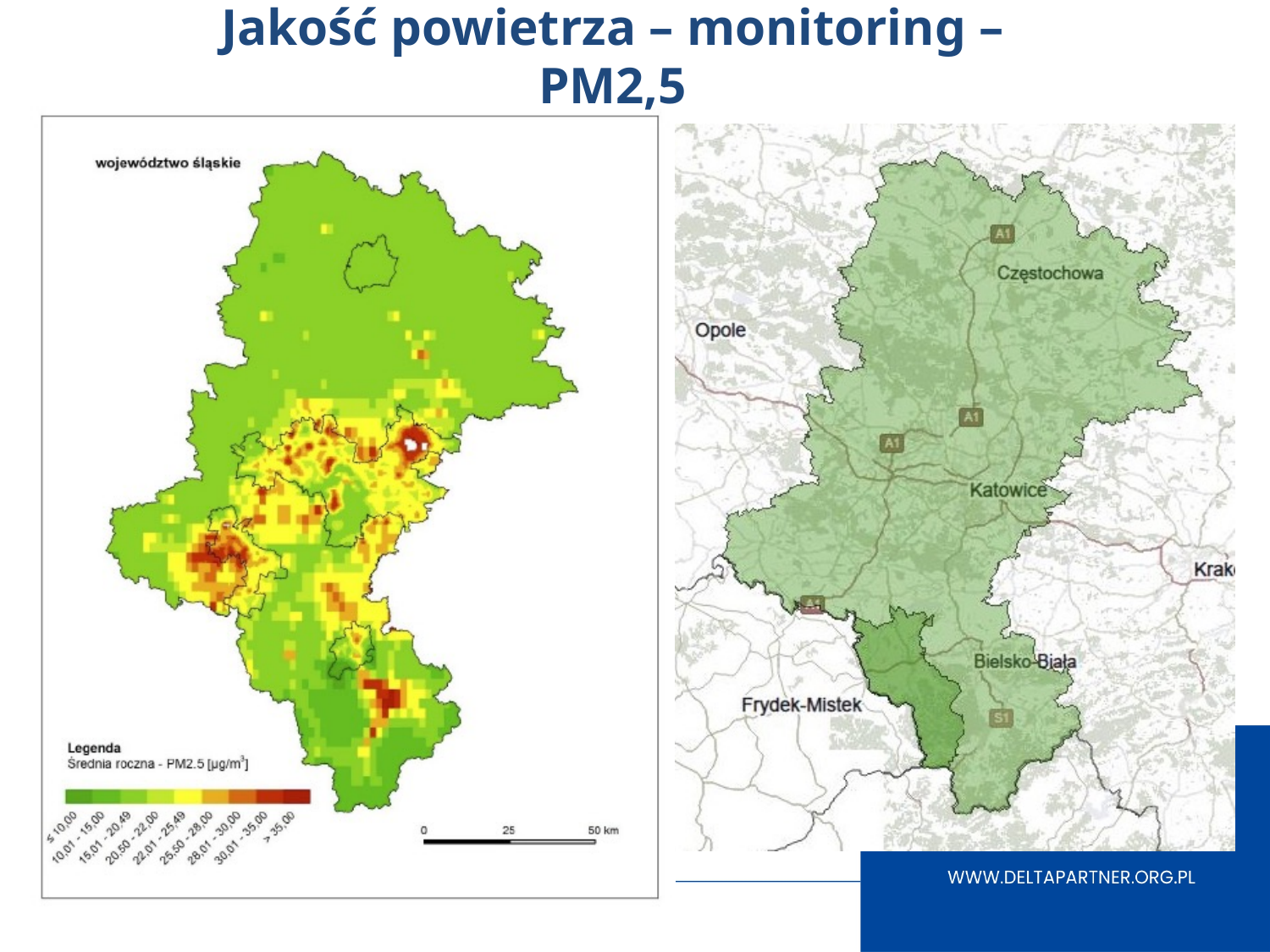
What kind of visualisation is shown on the left side of the slide? A map On the left map, what is the largest distance marked on the scale bar? 50 km On the left map, what is the lowest value class in the legend? ≤ 10,00 On the left map, what quantity does the legend say is shown? Średnia roczna - PM2.5 [µg/m³] Which region is named in the top-left corner of the left map? województwo śląskie On the left map, what is the highest value class in the legend? > 35,00 On the left map, how many value classes does the legend colour scale list? 9